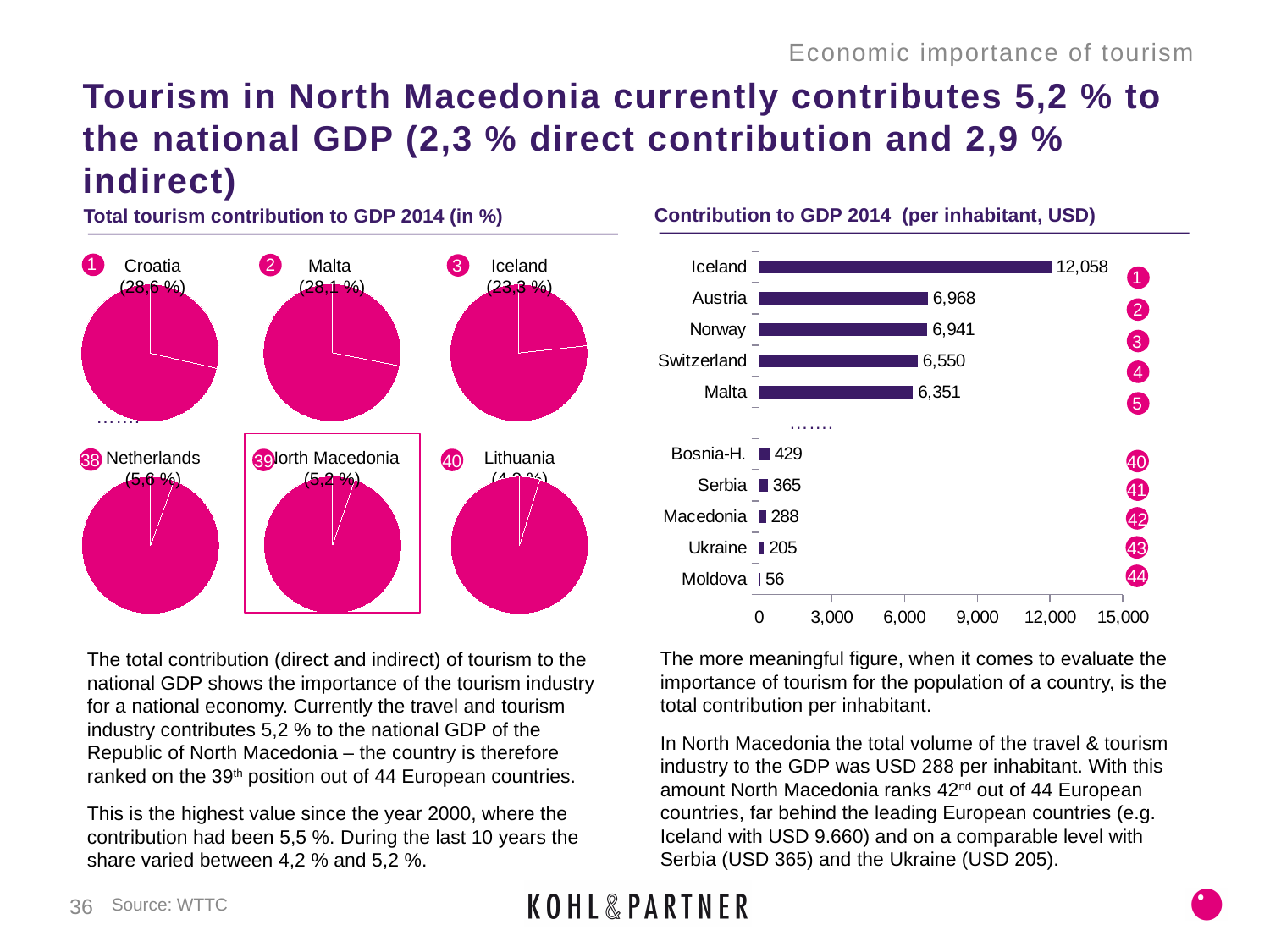
In the 'Contribution to GDP 2014 (per inhabitant, USD)' chart, which is larger, the value for Austria or the value for Malta? Austria In the 'Contribution to GDP 2014 (per inhabitant, USD)' chart, what is the difference between the values for Serbia and Ukraine? 160 In the 'Contribution to GDP 2014 (per inhabitant, USD)' chart, which country has the highest value? Iceland In the 'Contribution to GDP 2014 (per inhabitant, USD)' chart, what is the value for Macedonia? 288 In the 'Contribution to GDP 2014 (per inhabitant, USD)' chart, is the value for Norway greater or less than 6,000? greater In the 'Total tourism contribution to GDP 2014 (in %)' pie charts, what is the value shown for Croatia? 28,6 % In the 'Contribution to GDP 2014 (per inhabitant, USD)' chart, what is the value for Switzerland? 6,550 How many countries are shown in the 'Contribution to GDP 2014 (per inhabitant, USD)' chart? 10 In the 'Contribution to GDP 2014 (per inhabitant, USD)' chart, which country has the lowest value? Moldova What kind of chart is the 'Contribution to GDP 2014 (per inhabitant, USD)' chart? Bar chart In the 'Total tourism contribution to GDP 2014 (in %)' pie charts, what is the value shown for North Macedonia? 5,2 % In the 'Contribution to GDP 2014 (per inhabitant, USD)' chart, what is the value for Iceland? 12,058